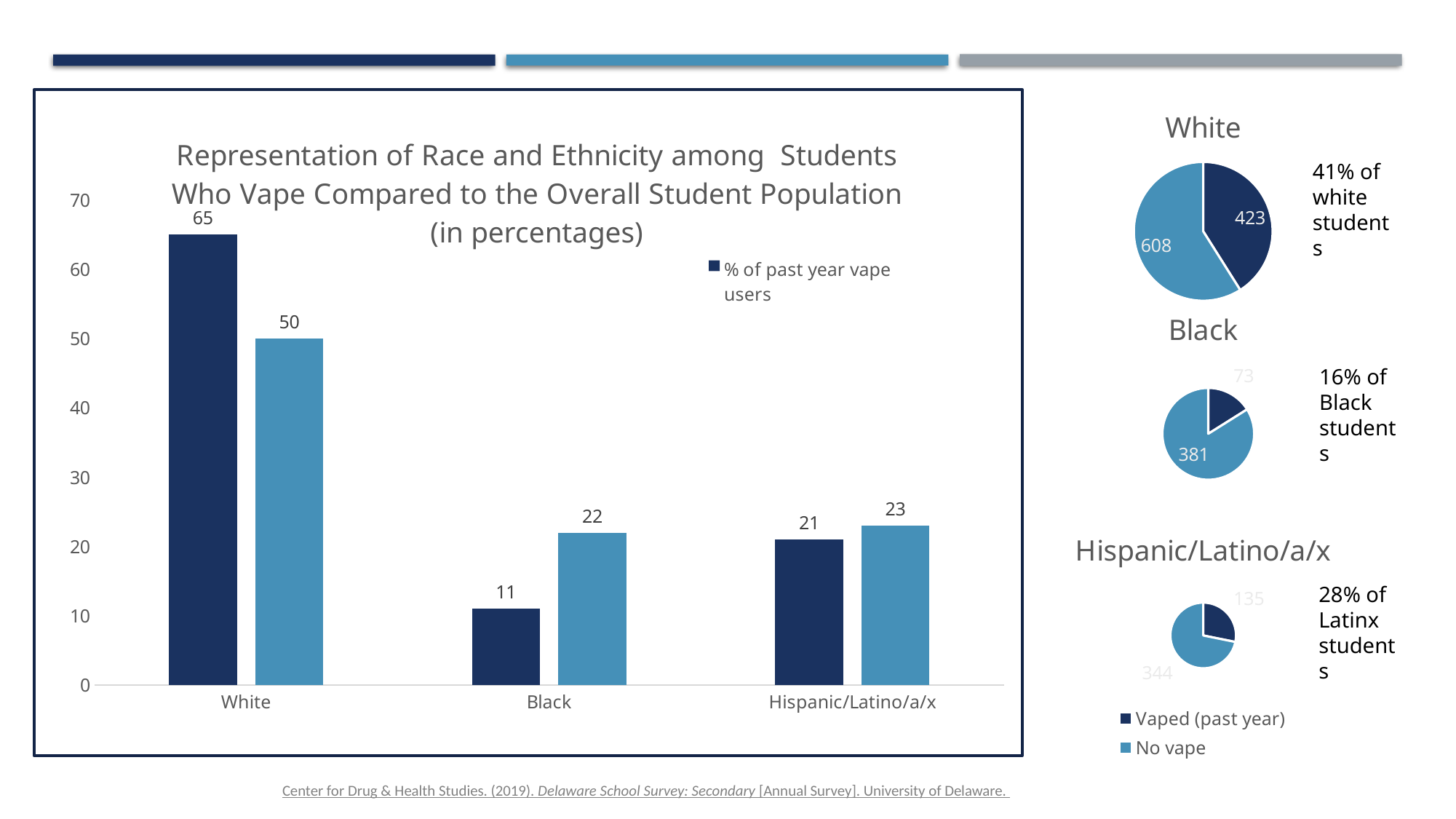
In the bar chart, which category has the highest '% of past year vape users' value? White In the bar chart, what is the value of the '% of past year vape users' bar for White? 65 In the bar chart, for Black, which bar is larger: the dark blue '% of past year vape users' bar or the light blue bar? the light blue bar In the bar chart, which category has the lowest '% of past year vape users' value? Black In the 'Black' pie chart, what is the total of the two slices (73 and 381)? 454 How many categories are shown on the x axis of the bar chart? 3 In the bar chart, what is the value of the '% of past year vape users' bar for Black? 11 In the bar chart, what is the value of the light blue bar for Hispanic/Latino/a/x? 23 What kind of chart is the large chart on the left of the slide? bar chart In the bar chart, what is the difference between the two bars for White (65 and 50)? 15 How many series does the legend below the pie charts list? 2 In the 'White' pie chart, how many students are in the 'Vaped (past year)' slice? 423